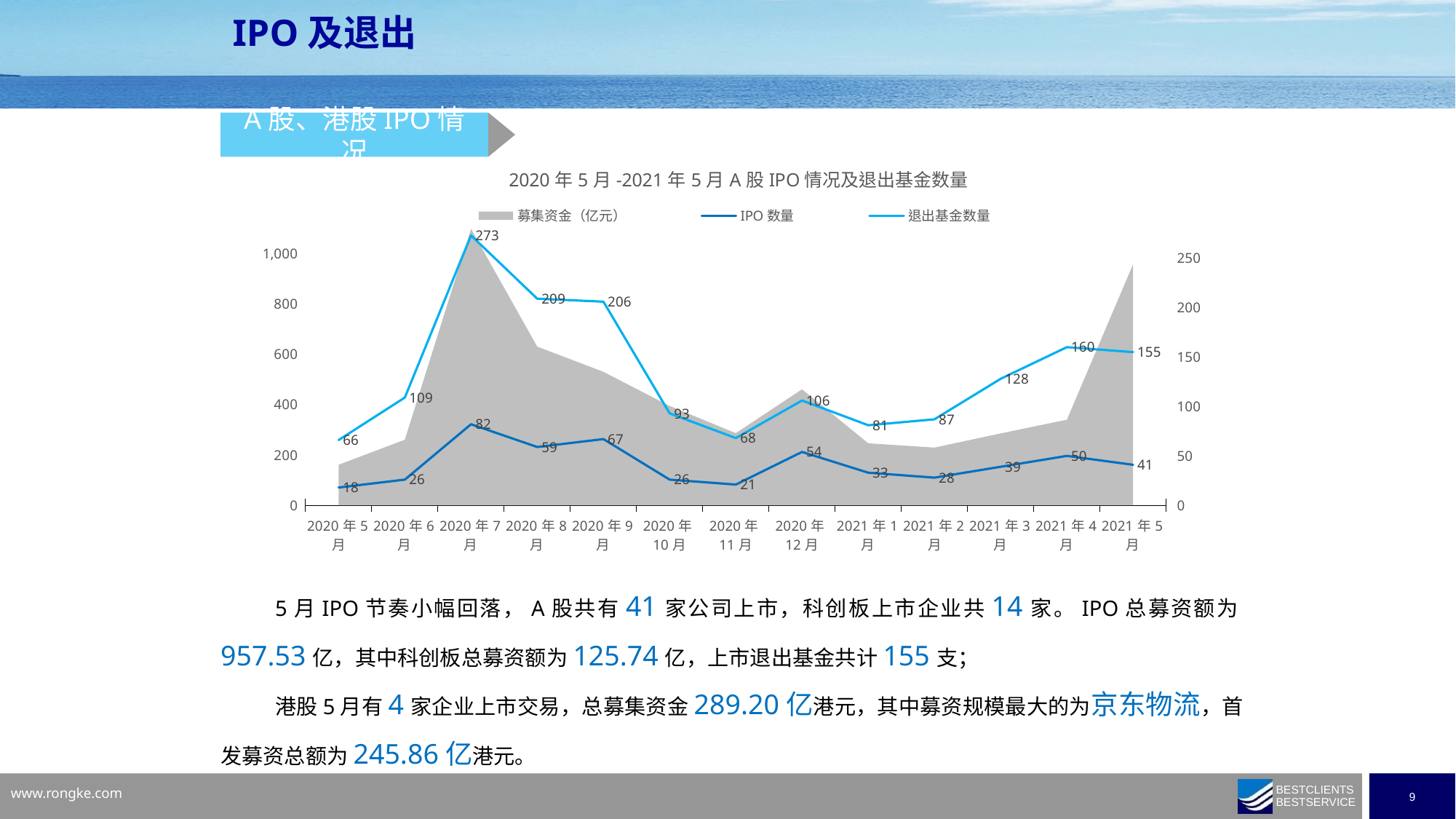
How many months are plotted along the x axis of the chart? 13 What is the title of the chart? 2020年5月-2021年5月A股IPO情况及退出基金数量 What is the 退出基金数量 value for 2021年5月? 155 Does the 退出基金数量 rise or fall from 2021年1月 to 2021年4月? rise Which is larger, the IPO 数量 for 2020年9月 or for 2020年12月? 2020年9月 What is the difference between the 退出基金数量 for 2021年4月 and 2021年5月? 5 How many series does the chart legend list? 3 Is the 募集资金（亿元） value for 2021年5月 greater or less than 800? greater Which month has the highest 退出基金数量? 2020年7月 Which month has the lowest IPO 数量? 2020年5月 Is the 募集资金（亿元） value for 2020年5月 greater or less than 200? less What is the IPO 数量 value for 2020年7月? 82